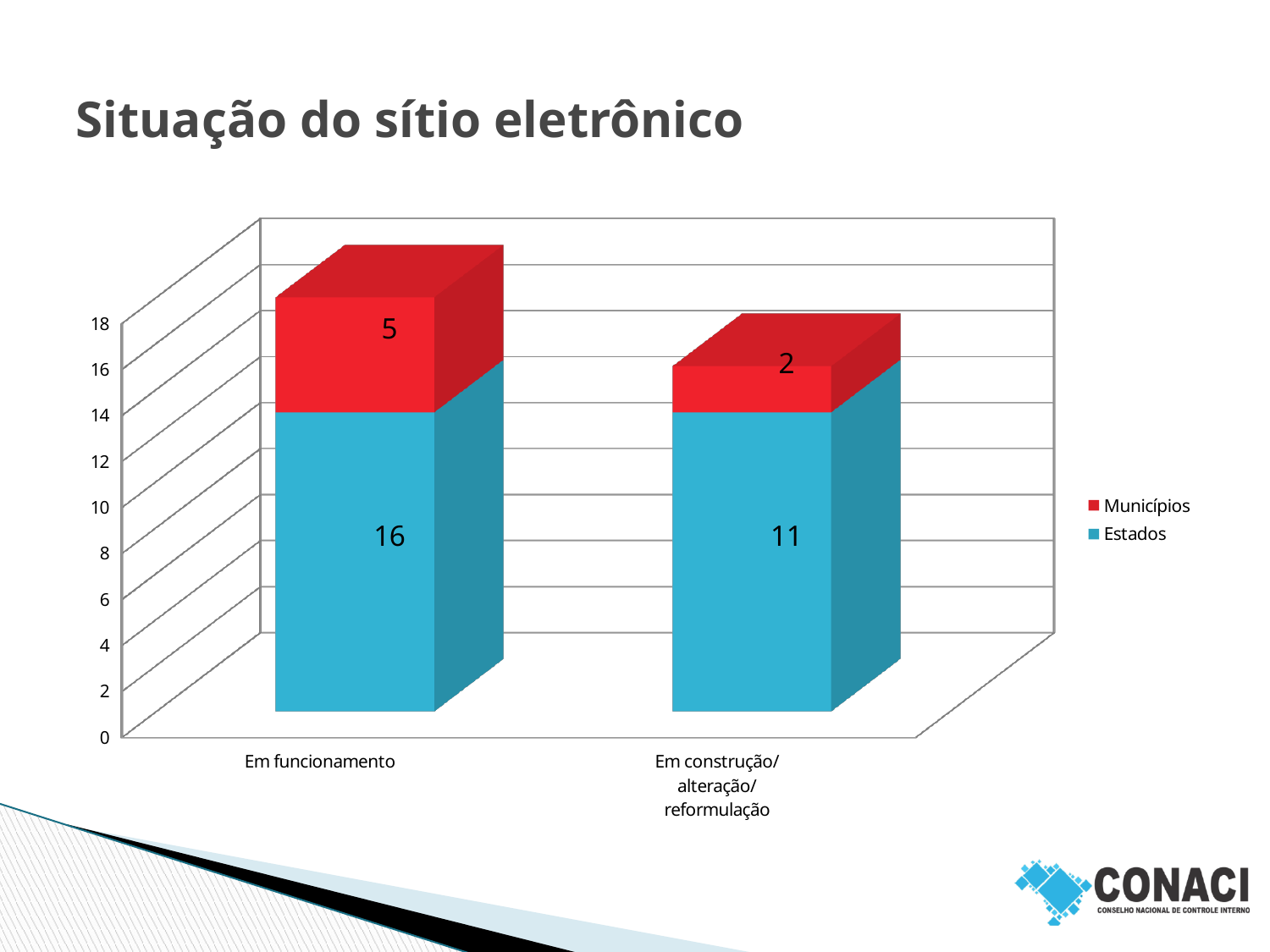
What is the difference between the Estados values for 'Em funcionamento' and 'Em construção/alteração/reformulação'? 5 What is the value for Estados in the 'Em funcionamento' category? 16 What is the total of the stacked bar for 'Em funcionamento'? 21 Which category has the lowest value for Municípios? Em construção/alteração/reformulação What is the value for Municípios in the 'Em funcionamento' category? 5 What is the value for Municípios in the 'Em construção/alteração/reformulação' category? 2 What is the total of the stacked bar for 'Em construção/alteração/reformulação'? 13 Which is larger: Municípios for 'Em funcionamento' or Municípios for 'Em construção/alteração/reformulação'? Em funcionamento How many series does the legend list? 2 What is the value for Estados in the 'Em construção/alteração/reformulação' category? 11 Which category has the highest value for Estados? Em funcionamento What kind of chart is shown on the slide? Stacked bar chart